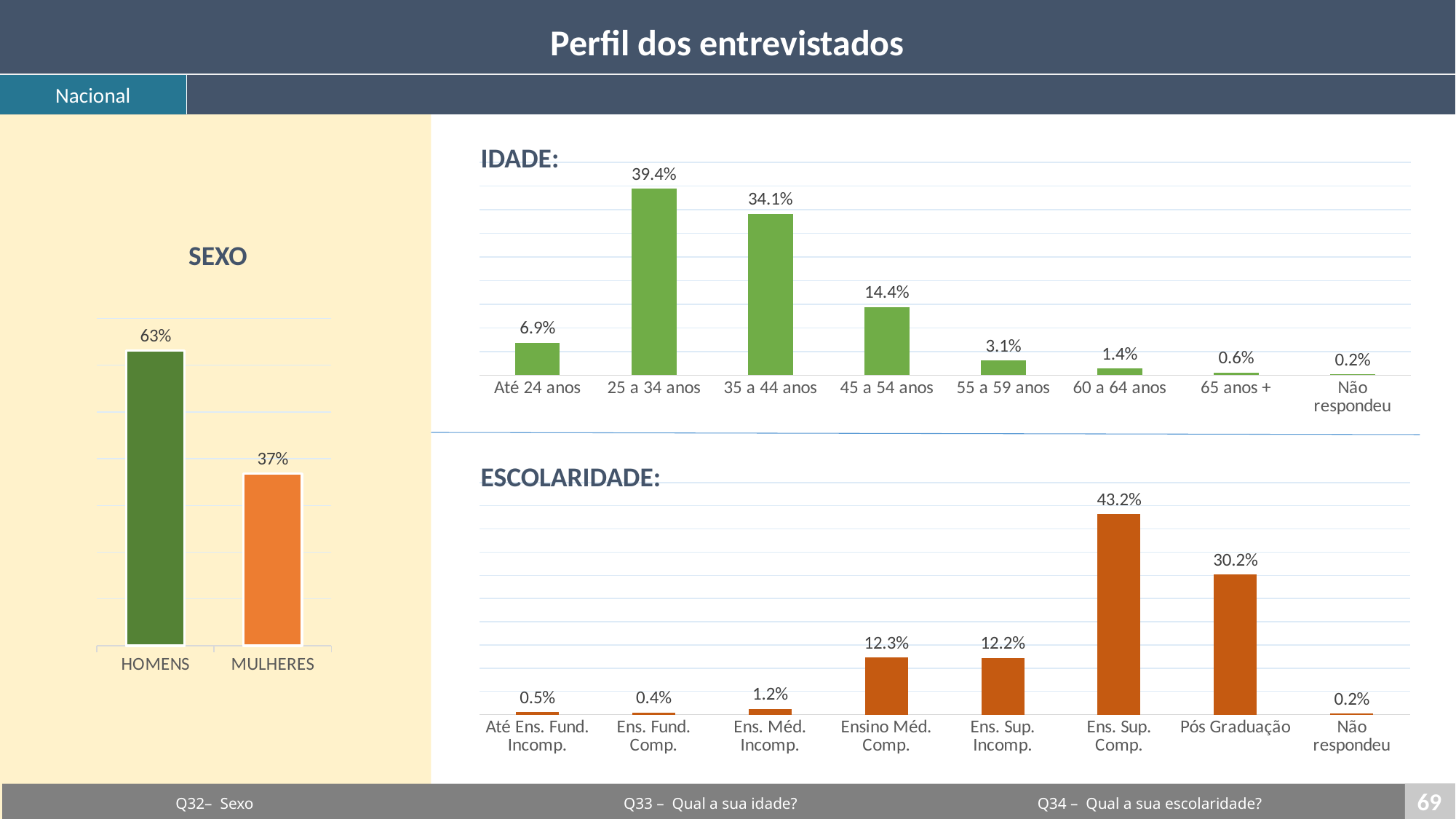
In the IDADE chart, do the values rise or fall from 25 a 34 anos to Não respondeu? Fall In the IDADE chart, which category has the lowest value? Não respondeu In the SEXO chart, what is the difference between HOMENS and MULHERES? 26% In the ESCOLARIDADE chart, which is larger, Ens. Fund. Comp. or Ens. Méd. Incomp.? Ens. Méd. Incomp. In the IDADE chart, what is the difference between 25 a 34 anos and 45 a 54 anos? 25.0% In the SEXO chart, what is the value for HOMENS? 63% What type of chart is the ESCOLARIDADE chart? Bar chart In the ESCOLARIDADE chart, what is the value for Pós Graduação? 30.2% In the IDADE chart, which age group has the highest value? 25 a 34 anos In the IDADE chart, what is the value for 35 a 44 anos? 34.1% In the IDADE chart, how many categories are shown? 8 In the ESCOLARIDADE chart, which category has the highest value? Ens. Sup. Comp.